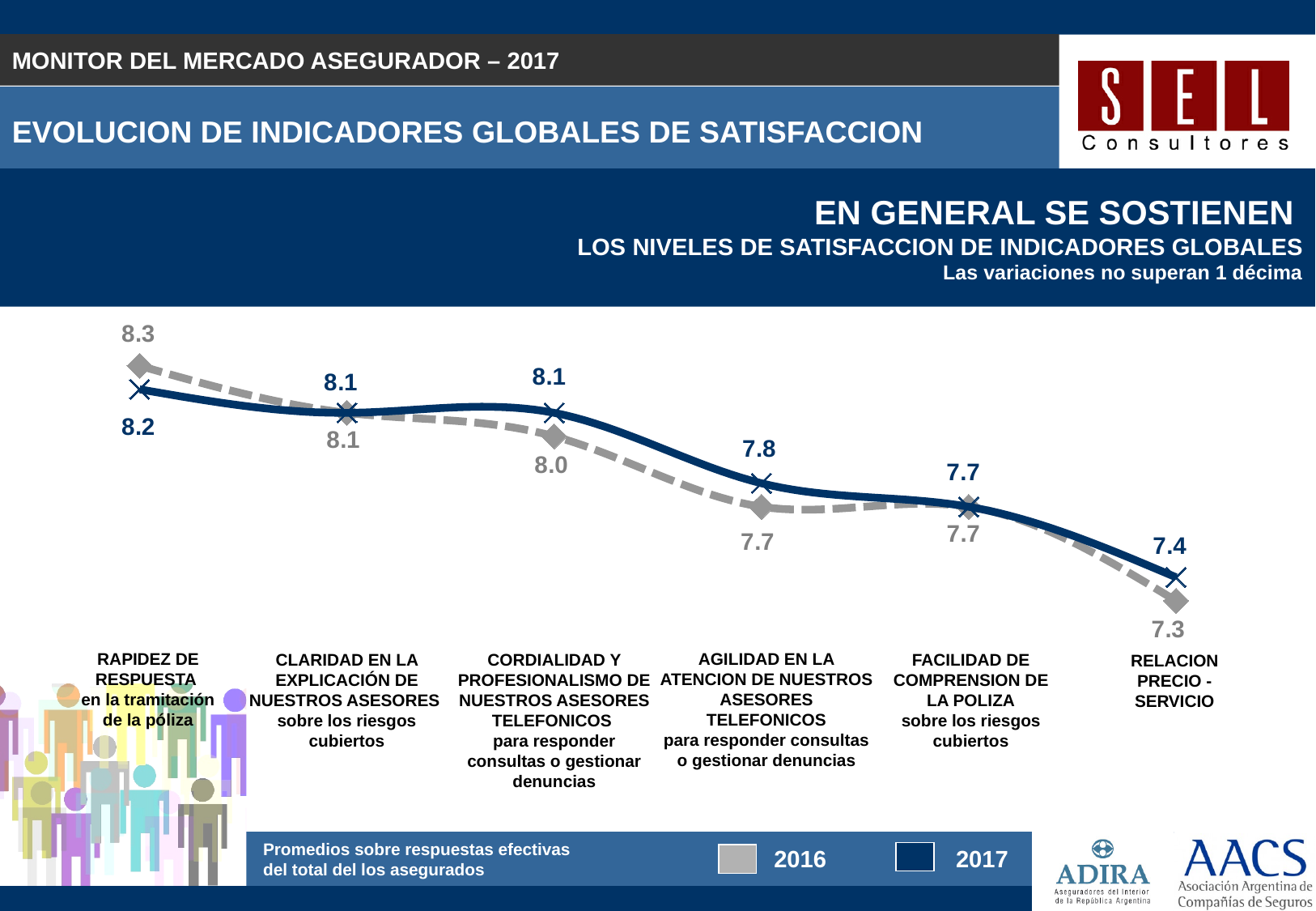
How many series does the legend list? 2 What is the 2017 value for RAPIDEZ DE RESPUESTA? 8.2 How many categories are plotted on the chart? 6 Which category has the highest 2016 value? RAPIDEZ DE RESPUESTA What is the 2016 value for CORDIALIDAD Y PROFESIONALISMO DE NUESTROS ASESORES TELEFONICOS? 8.0 Which colour represents the 2016 series in the legend? grey Which category has the lowest 2017 value? RELACION PRECIO - SERVICIO What is the difference between the 2016 and 2017 values for RAPIDEZ DE RESPUESTA? 0.1 What kind of chart is shown on the slide? line chart Do the 2017 values generally rise or fall from left to right across the categories? fall What is the 2017 value for RELACION PRECIO - SERVICIO? 7.4 For AGILIDAD EN LA ATENCION DE NUESTROS ASESORES TELEFONICOS, which year has the larger value, 2016 or 2017? 2017